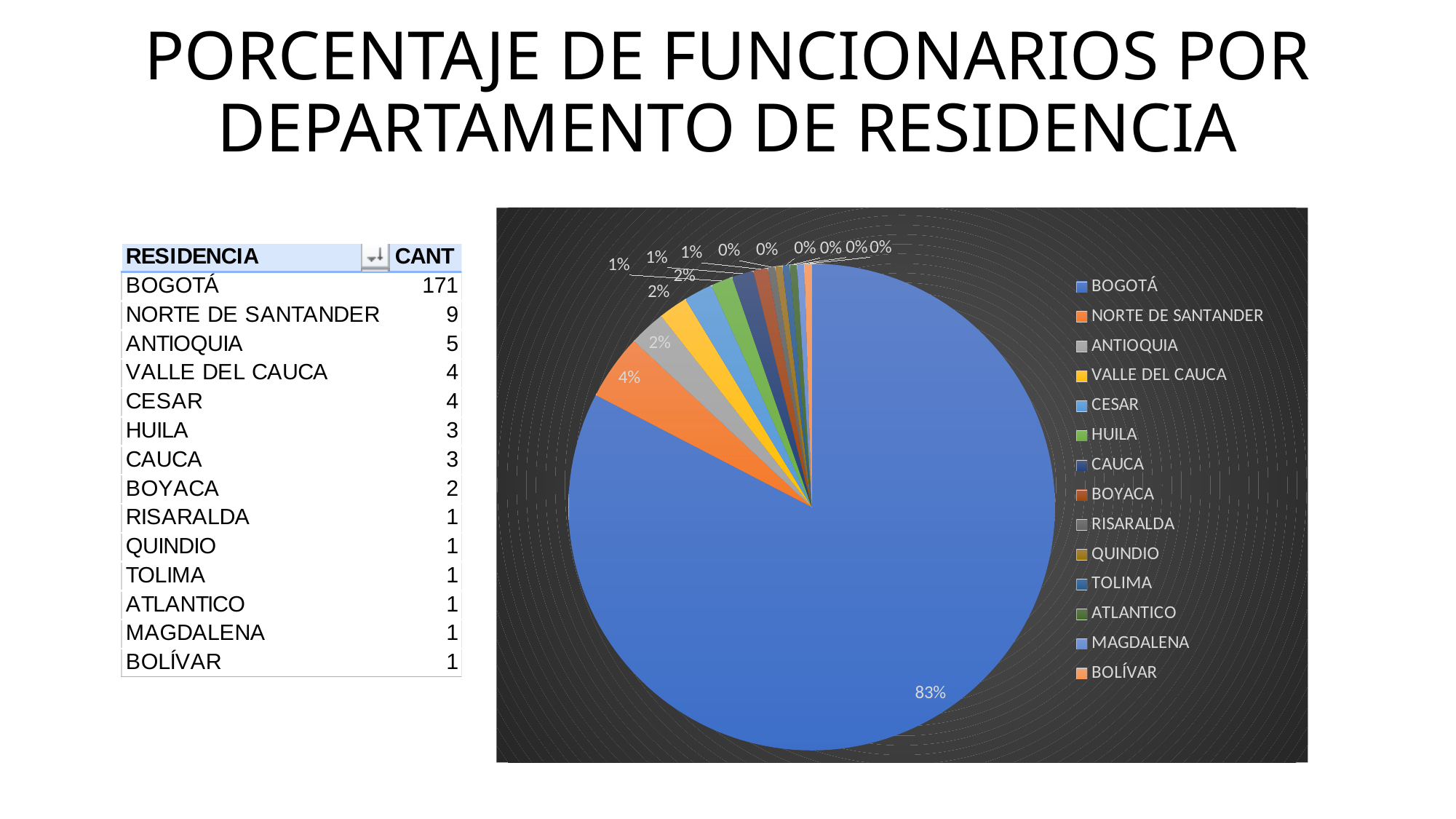
What is the difference in percentage points between the BOGOTÁ slice and the NORTE DE SANTANDER slice? 79% What kind of chart is shown on the slide? pie chart What share of the pie does BOGOTÁ represent? 83% What colour is the BOGOTÁ slice in the pie chart? blue What percentage is shown for HUILA in the pie chart? 1% How many departments are listed in the pie chart's legend? 14 Which department has the largest slice of the pie chart? BOGOTÁ Which department is listed first in the pie chart's legend? BOGOTÁ What percentage is shown for ANTIOQUIA in the pie chart? 2% What percentage is shown for RISARALDA in the pie chart? 0% Which slice is larger in the pie chart, NORTE DE SANTANDER or ANTIOQUIA? NORTE DE SANTANDER What share of the pie does NORTE DE SANTANDER represent? 4%